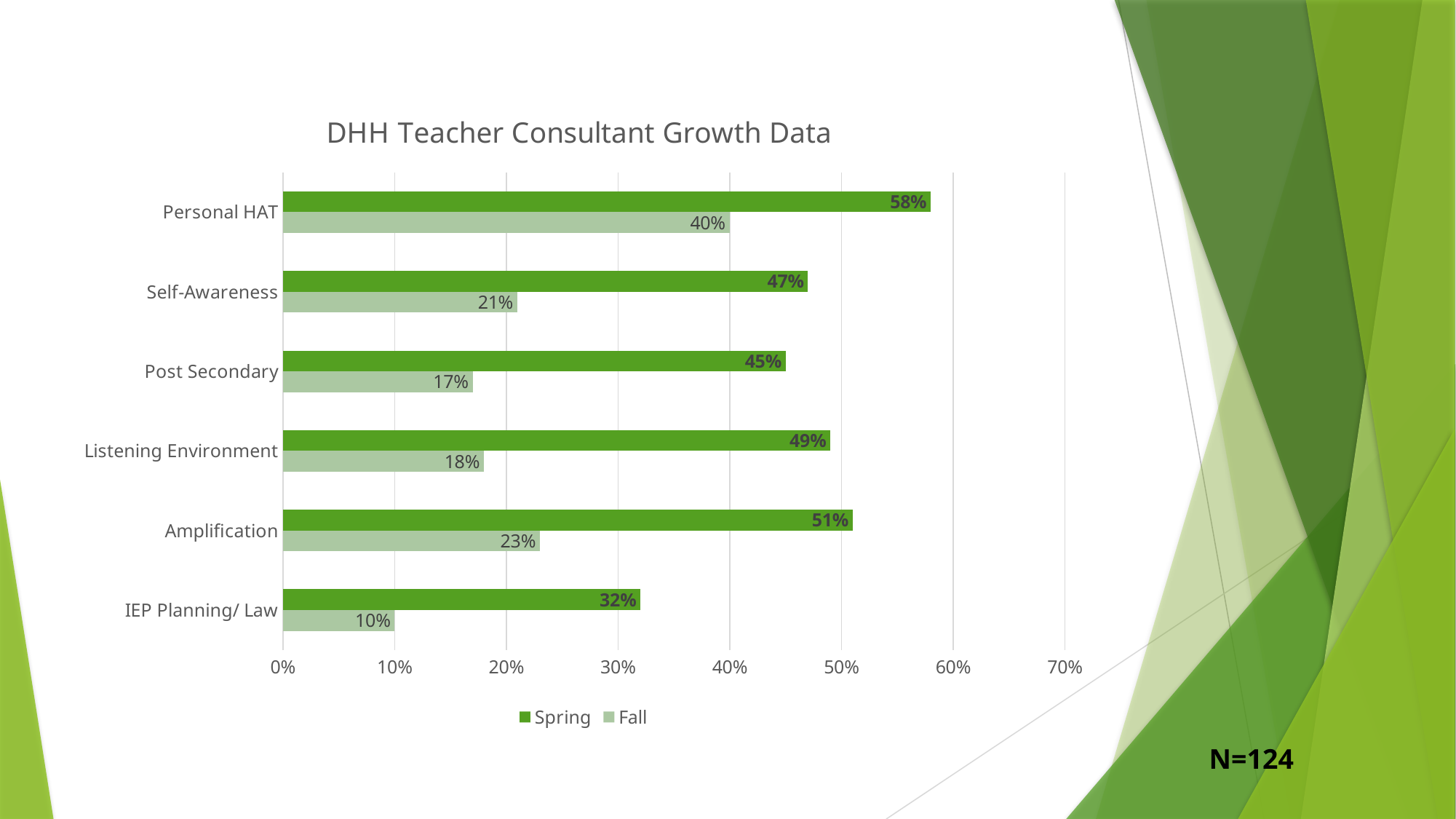
Which category has the highest Spring value? Personal HAT What is the Fall value for Self-Awareness? 21% What is the Spring value for Personal HAT? 58% What is the difference between the Spring and Fall values for Post Secondary? 28% What kind of chart is shown on the slide? bar chart How many series does the legend list? 2 How many categories are shown on the chart? 6 Which category has the lowest Fall value? IEP Planning/ Law What is the title of the chart? DHH Teacher Consultant Growth Data What is the Fall value for IEP Planning/ Law? 10% Is the Spring value for Amplification greater or less than 40%? greater Which is larger, the Fall value for Amplification or the Fall value for Listening Environment? Amplification